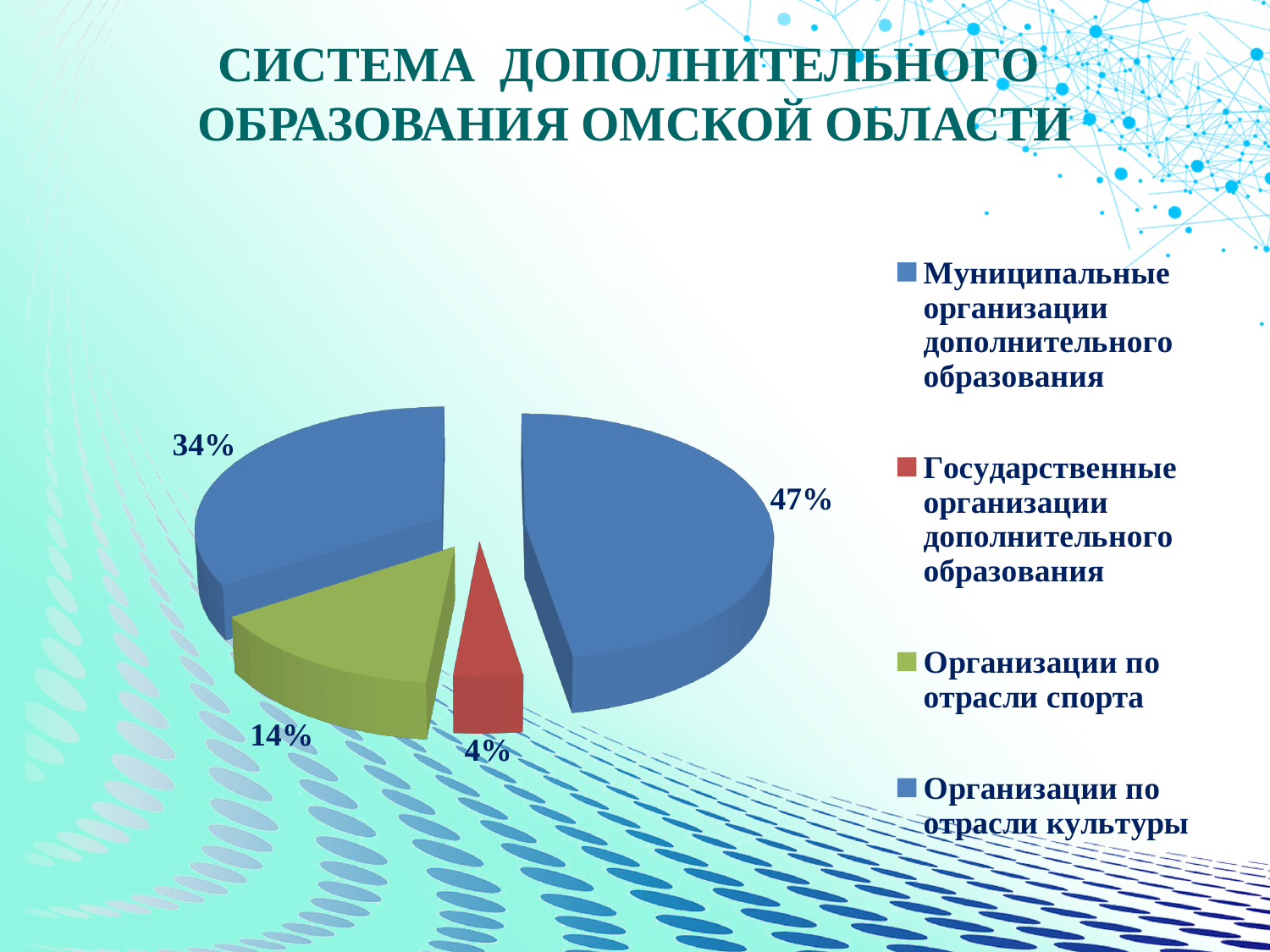
How many entries does the legend list? 4 What is the difference between the green slice (14%) and the red slice (4%)? 10% What is the value of the smallest slice in the pie chart? 4% What share of the pie is labelled for Организации по отрасли спорта (the green slice)? 14% What is the difference between the largest slice (47%) and the slice labelled 34%? 13% What colour is the slice for Организации по отрасли спорта? green What kind of chart is shown on the slide? pie chart Which legend category corresponds to the smallest slice of the pie? Государственные организации дополнительного образования What is the value of the largest slice in the pie chart? 47% Which is larger: the slice for Организации по отрасли спорта or the slice for Государственные организации дополнительного образования? Организации по отрасли спорта What share of the pie is labelled for Государственные организации дополнительного образования (the red slice)? 4% How many slices does the pie chart have? 4